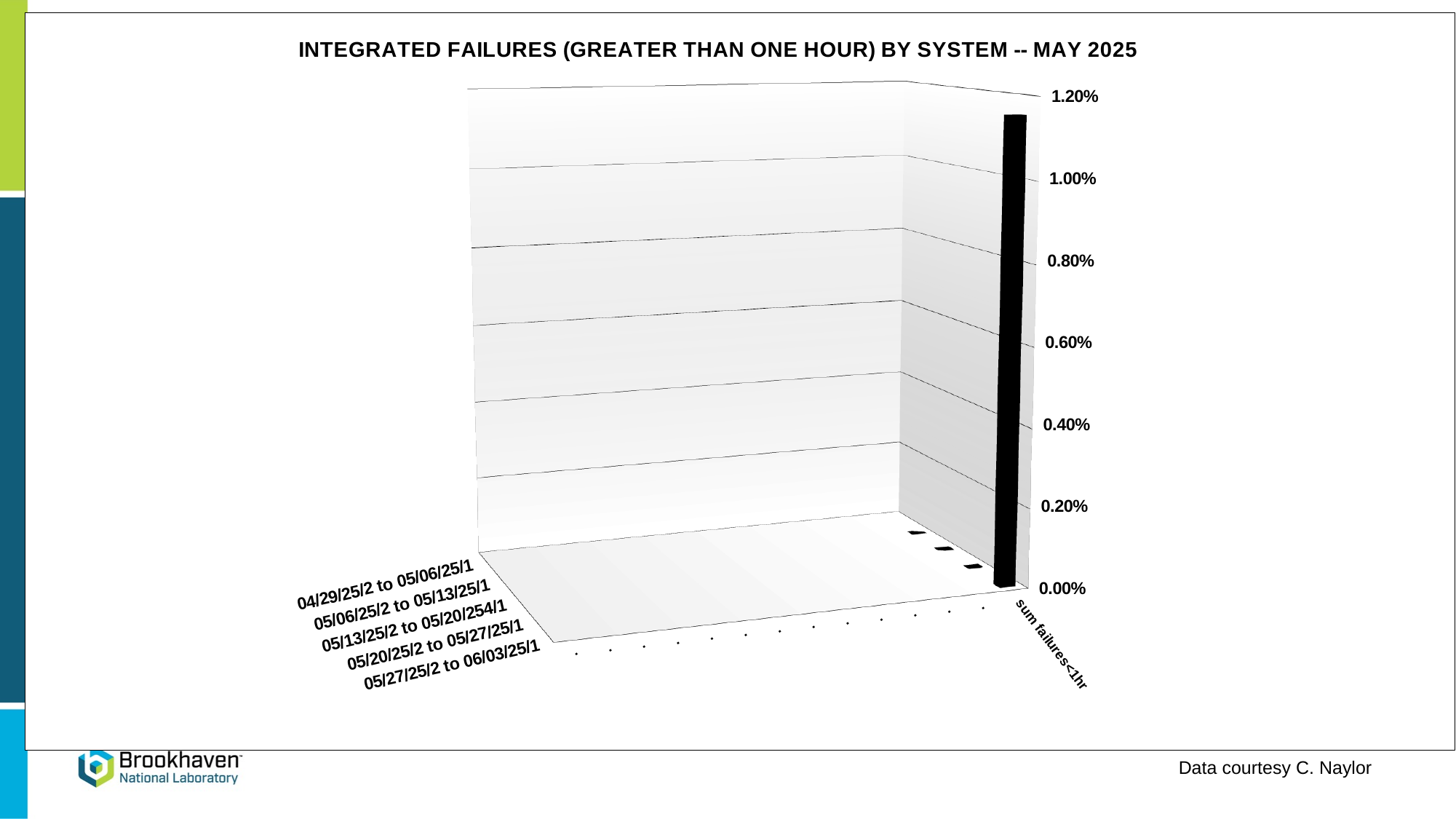
Is the value of the tallest bar greater or less than 1.00%? greater What is the highest tick value shown on the vertical axis? 1.20% What is the first date-range category listed on the category axis? 04/29/25/2 to 05/06/25/1 What kind of chart is shown on the slide? bar chart What is the title of the chart? INTEGRATED FAILURES (GREATER THAN ONE HOUR) BY SYSTEM -- MAY 2025 Is the value of the tallest bar greater or less than 0.60%? greater What is the last date-range category listed on the category axis? 05/27/25/2 to 06/03/25/1 How many date-range categories are labelled on the chart's category axis? 5